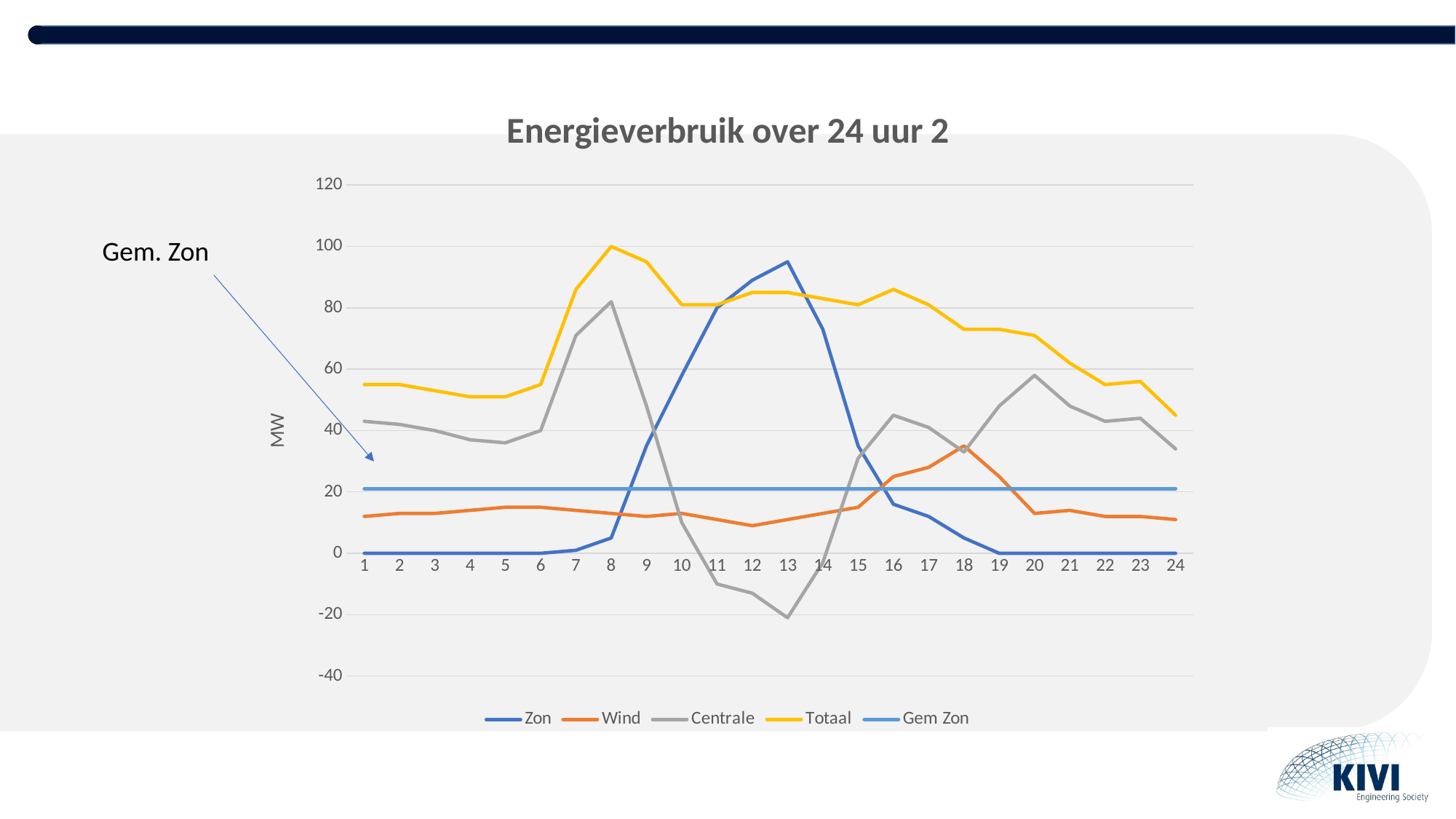
What is the value of the Zon series at hour 3? 0 What is the title of the chart? Energieverbruik over 24 uur 2 How many points are plotted along the x axis for each series? 24 At which hour does the Zon series reach its highest value? 13 At which hour does the Centrale series reach its lowest value? 13 What is the label on the vertical axis? MW Is the value of the Totaal series at hour 24 greater or less than 60? less What kind of chart is shown on the slide? line chart Is the value of the Centrale series at hour 8 greater or less than 60? greater How many series does the legend list? 5 At hour 20, which series has the larger value, Centrale or Wind? Centrale At which hour does the Totaal series reach its highest value? 8